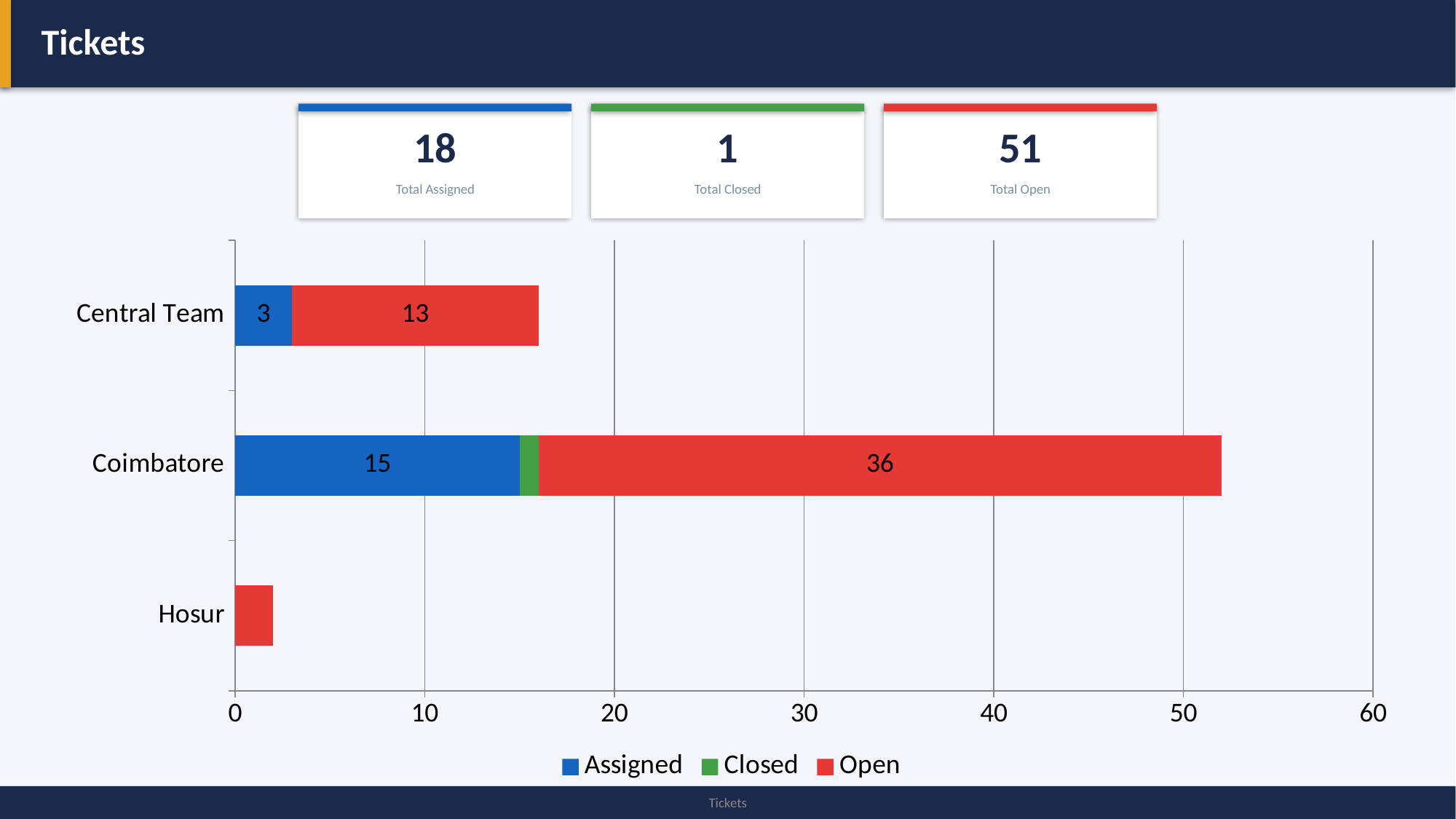
What is the total of the stacked bar for Central Team? 16 What is the Assigned value for Coimbatore? 15 How many categories are shown on the chart? 3 What is the Open value for Coimbatore? 36 How many series does the legend list? 3 What kind of chart is shown on the slide? Stacked bar chart Is the Open value for Hosur greater or less than 10? less What is the Open value for Central Team? 13 Which has the larger Assigned value, Coimbatore or Central Team? Coimbatore Which category has the highest Open value? Coimbatore What is the difference between the Open values for Coimbatore and Central Team? 23 What is the Assigned value for Central Team? 3